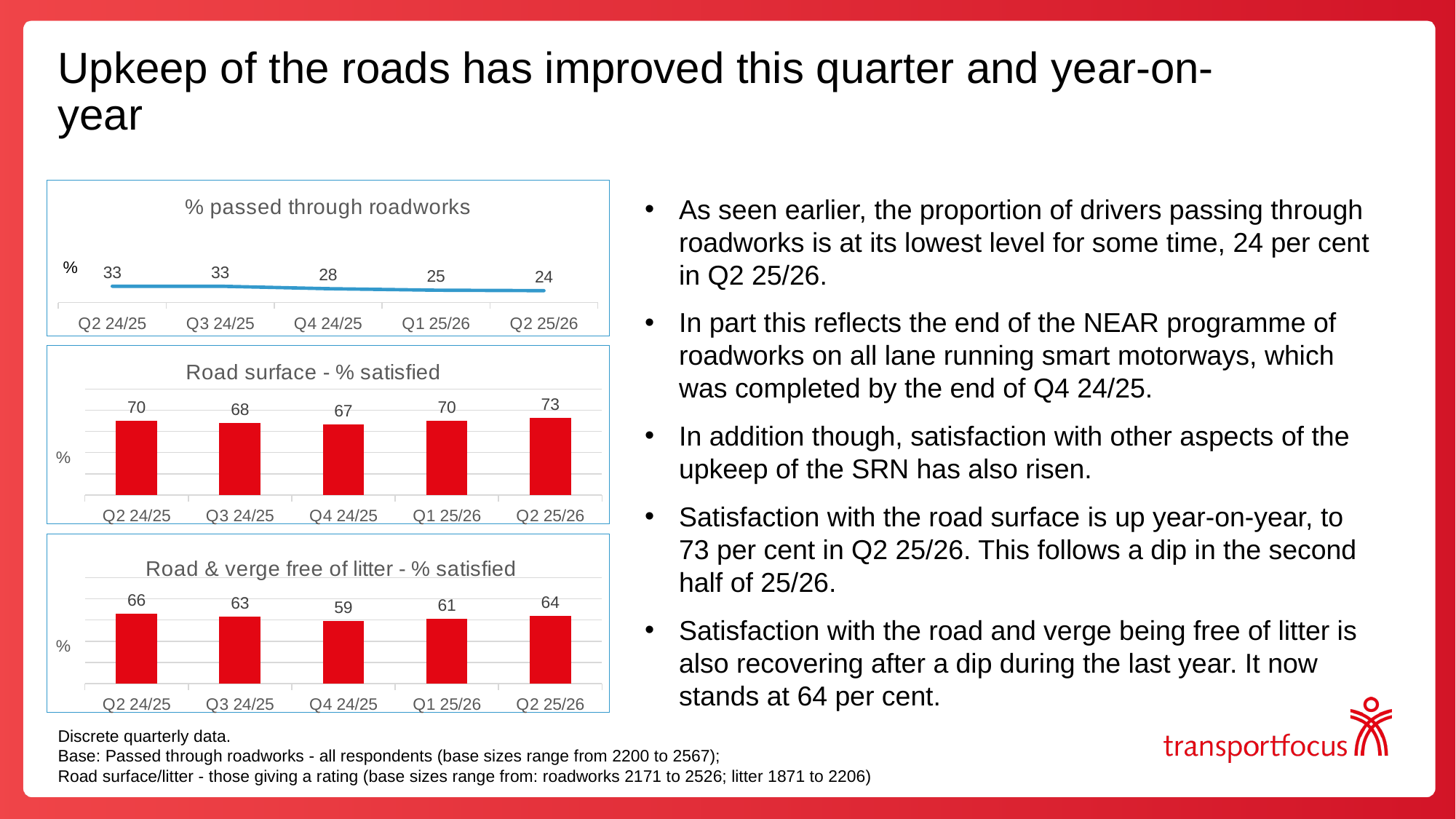
In the '% passed through roadworks' chart, do the values rise or fall from Q2 24/25 to Q2 25/26? fall In the 'Road surface - % satisfied' chart, what is the value for Q3 24/25? 68 In the 'Road & verge free of litter - % satisfied' chart, which is larger, Q2 24/25 or Q2 25/26? Q2 24/25 In the '% passed through roadworks' chart, what kind of chart is shown? line chart In the 'Road surface - % satisfied' chart, which quarter has the lowest value? Q4 24/25 In the '% passed through roadworks' chart, what is the value for Q2 25/26? 24 In the 'Road & verge free of litter - % satisfied' chart, what is the difference between Q1 25/26 and Q2 25/26? 3 In the '% passed through roadworks' chart, what is the difference between Q2 24/25 and Q2 25/26? 9 In the 'Road surface - % satisfied' chart, which quarter has the highest value? Q2 25/26 In the 'Road surface - % satisfied' chart, how many quarters are plotted? 5 In the 'Road & verge free of litter - % satisfied' chart, what is the value for Q4 24/25? 59 In the 'Road & verge free of litter - % satisfied' chart, what kind of chart is shown? bar chart